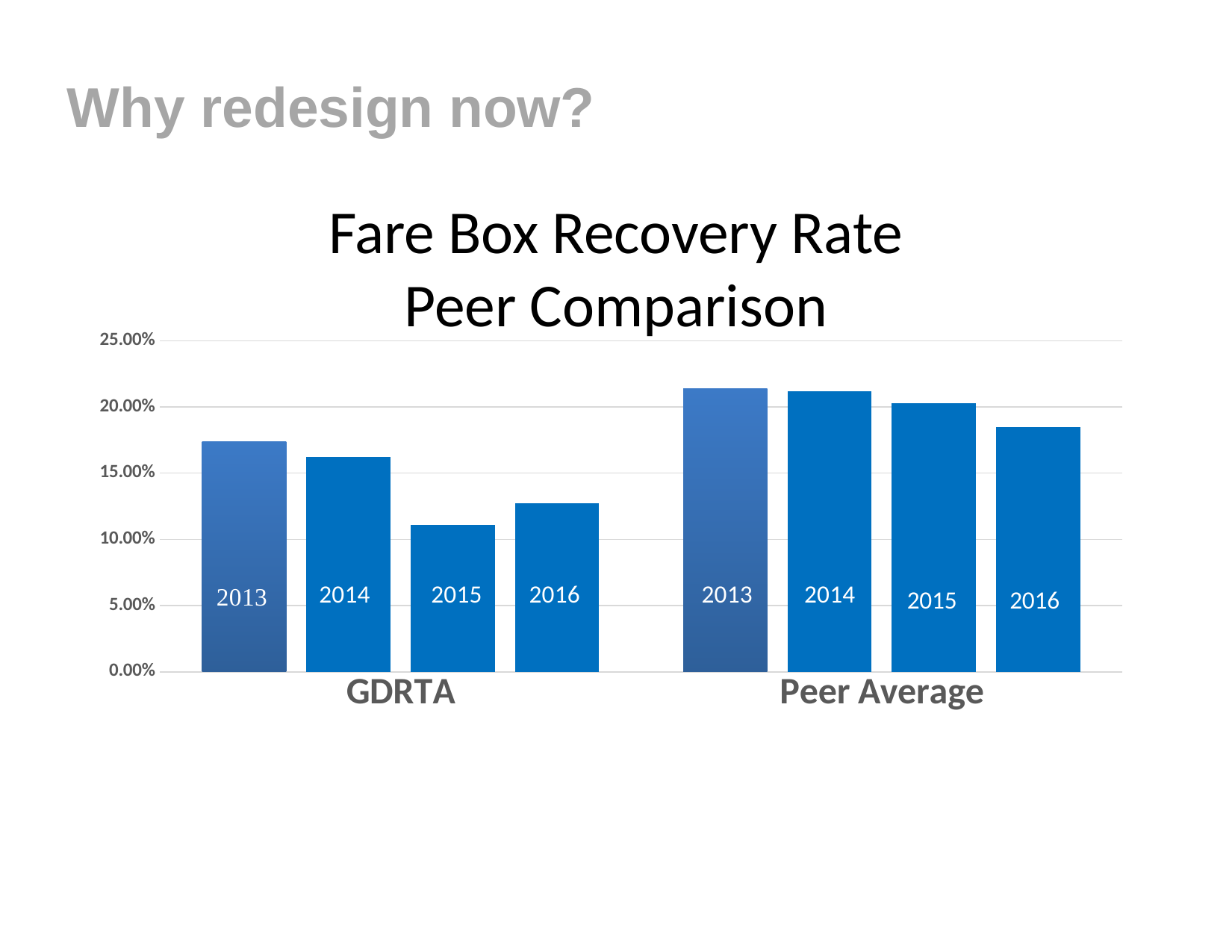
How many bars are plotted in the chart in total? 8 Which is larger in 2013, the GDRTA value or the Peer Average value? Peer Average What is the title of the chart? Fare Box Recovery Rate Peer Comparison Which year has the lowest fare box recovery rate for GDRTA? 2015 How many groups of bars are shown on the x axis? 2 Is the Peer Average value for 2013 greater or less than 20.00%? greater Which year has the lowest fare box recovery rate for the Peer Average? 2016 Which year has the highest fare box recovery rate for GDRTA? 2013 Do the Peer Average values rise or fall from 2013 to 2016? fall Is the Peer Average value for 2016 greater or less than 20.00%? less What kind of chart is shown on the slide? bar chart Is the GDRTA value for 2015 greater or less than 15.00%? less